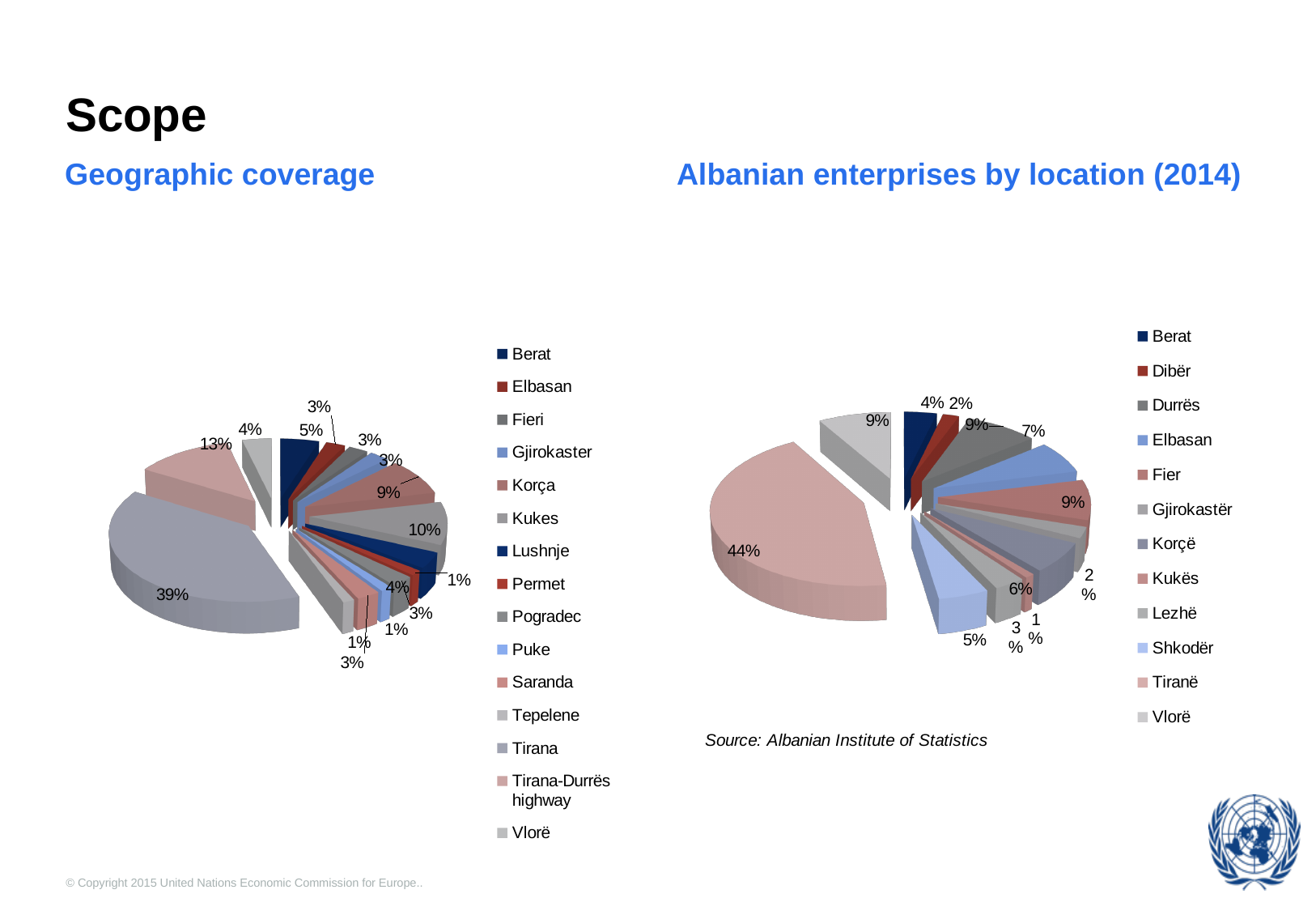
In the 'Geographic coverage' chart, how many categories does the legend list? 15 In the 'Geographic coverage' chart, what share is shown for Tirana-Durrës highway? 13% In the 'Geographic coverage' chart, which category has the largest share? Tirana In the 'Albanian enterprises by location (2014)' chart, what share is shown for Korçë? 6% In the 'Albanian enterprises by location (2014)' chart, how many locations does the legend list? 12 What type of chart is the 'Geographic coverage' chart? Pie chart In the 'Albanian enterprises by location (2014)' chart, which location has the largest share? Tiranë What source is cited below the 'Albanian enterprises by location (2014)' chart? Albanian Institute of Statistics In the 'Albanian enterprises by location (2014)' chart, what share is shown for Elbasan? 7% In the 'Geographic coverage' chart, what share is shown for Tirana? 39% In the 'Albanian enterprises by location (2014)' chart, what share of enterprises is in Tiranë? 44% In the 'Albanian enterprises by location (2014)' chart, what is the difference between the shares for Tiranë and Vlorë? 35%